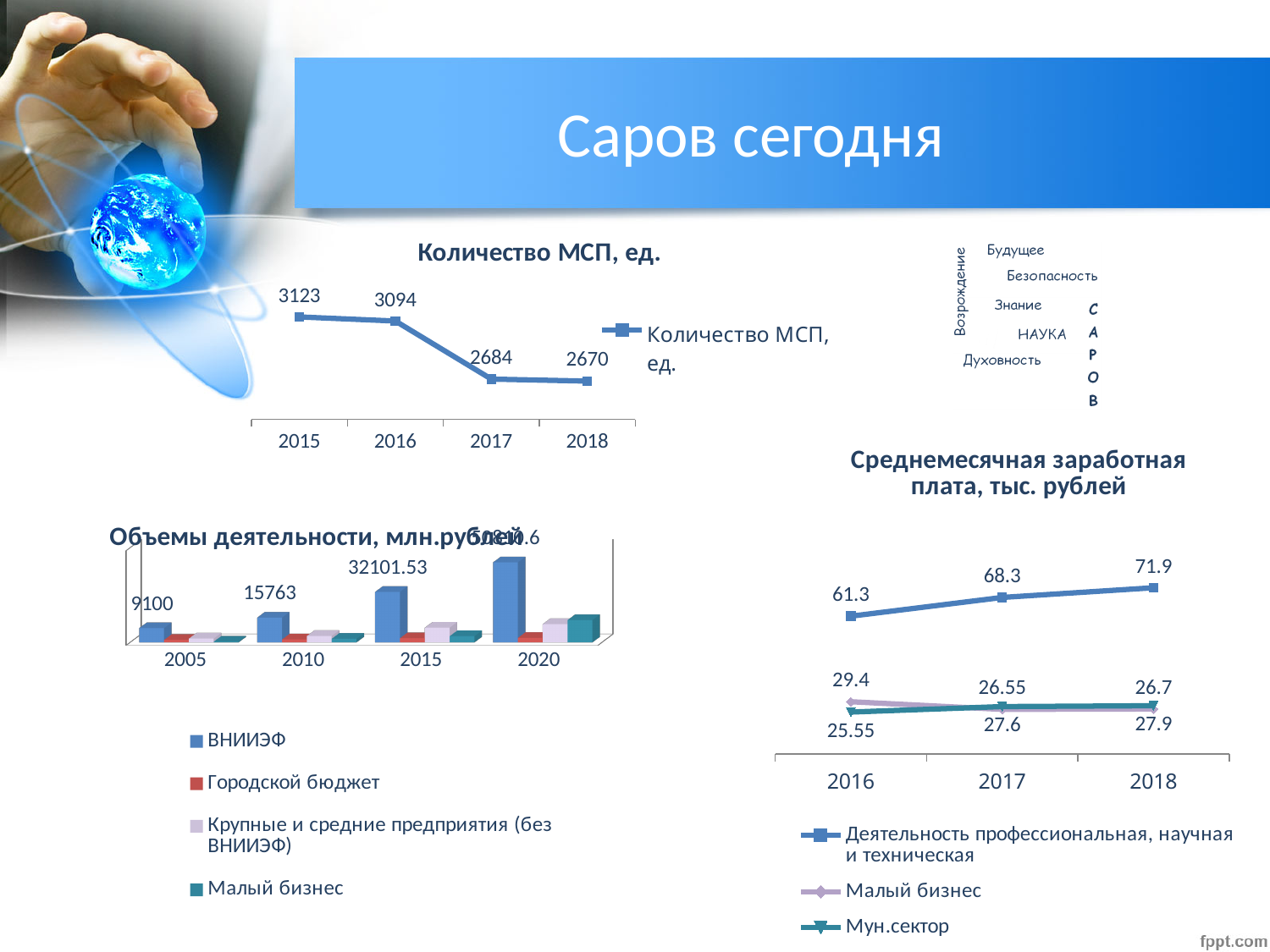
In the "Количество МСП, ед." chart, which year has the highest value? 2015 In the "Количество МСП, ед." chart, what is the difference between the 2015 and 2018 values? 453 How many series does the legend of the "Объемы деятельности, млн.рублей" chart list? 4 What kind of chart is "Количество МСП, ед."? line chart In the "Среднемесячная заработная плата, тыс. рублей" chart, by how much did "Деятельность профессиональная, научная и техническая" increase from 2016 to 2018? 10.6 In the "Среднемесячная заработная плата, тыс. рублей" chart, what is the 2018 value for "Деятельность профессиональная, научная и техническая"? 71.9 In the "Объемы деятельности, млн.рублей" chart, what is the value for ВНИИЭФ in 2015? 32101.53 How many years are shown on the x axis of the "Объемы деятельности, млн.рублей" chart? 4 In the "Количество МСП, ед." chart, what is the value for 2017? 2684 In the "Количество МСП, ед." chart, do the values rise or fall from 2015 to 2018? fall In the "Среднемесячная заработная плата, тыс. рублей" chart, what is the 2016 value for "Малый бизнес"? 29.4 In the "Количество МСП, ед." chart, which year has the lowest value? 2018